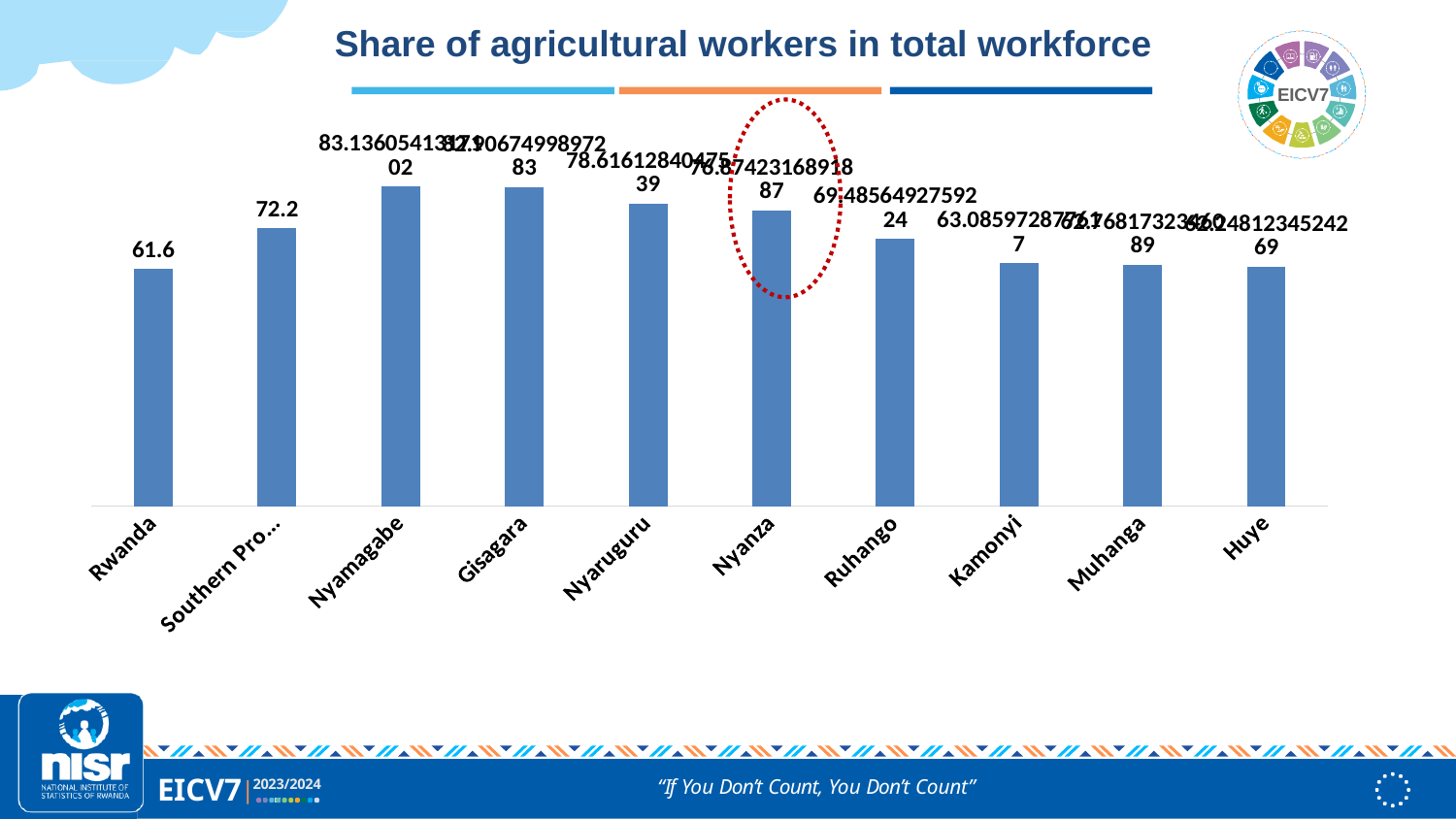
Which is larger, the value for Nyamagabe or the value for Huye? Nyamagabe What is the title of the chart? Share of agricultural workers in total workforce How many categories are shown on the x axis? 10 Which is larger, the value for Gisagara or the value for Kamonyi? Gisagara Which category's bar is highlighted with a red dotted circle? Nyanza Which category has the lowest value? Rwanda What is the difference between the values for Southern Pro... and Rwanda? 10.6 What is the value for Rwanda? 61.6 What type of chart is shown on the slide? bar chart Which is larger, the value for Rwanda or the value for Nyaruguru? Nyaruguru What is the value for Southern Pro...? 72.2 Which category has the highest value? Nyamagabe